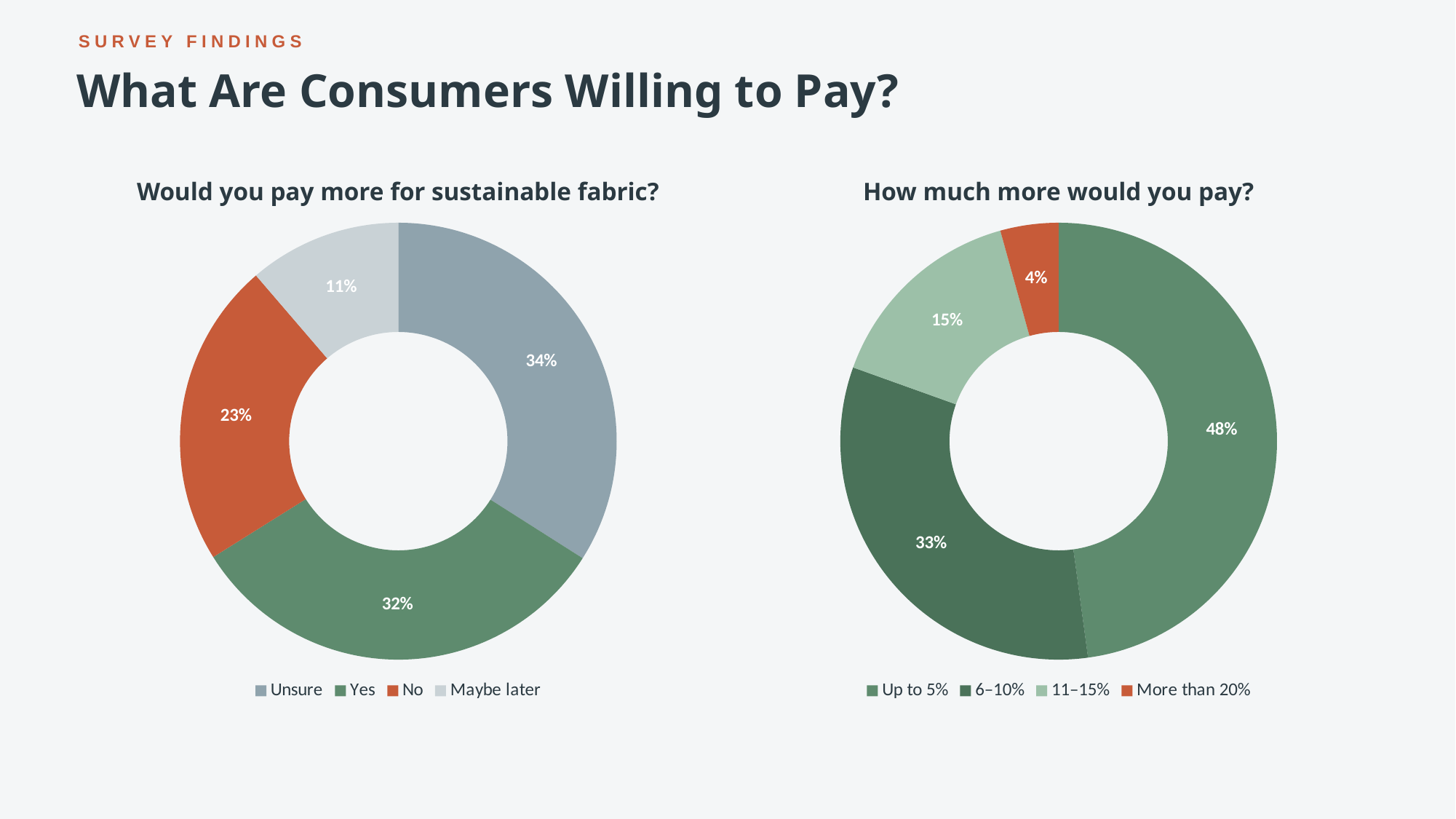
In the 'Would you pay more for sustainable fabric?' chart, what percentage answered Yes? 32% In the 'How much more would you pay?' chart, which category has the largest share? Up to 5% In the 'How much more would you pay?' chart, what percentage chose More than 20%? 4% In the 'How much more would you pay?' chart, what percentage chose 6–10%? 33% In the 'How much more would you pay?' chart, what is the difference between the Up to 5% and 6–10% shares? 15% In the 'Would you pay more for sustainable fabric?' chart, how many categories are shown? 4 In the 'Would you pay more for sustainable fabric?' chart, what is the difference between the Unsure and Maybe later shares? 23% In the 'Would you pay more for sustainable fabric?' chart, which response has the largest share? Unsure In the 'Would you pay more for sustainable fabric?' chart, what percentage answered No? 23% In the 'Would you pay more for sustainable fabric?' chart, which response has the smallest share? Maybe later In the 'How much more would you pay?' chart, which is larger: 11–15% or More than 20%? 11–15% What type of chart is used for 'How much more would you pay?'? Doughnut chart